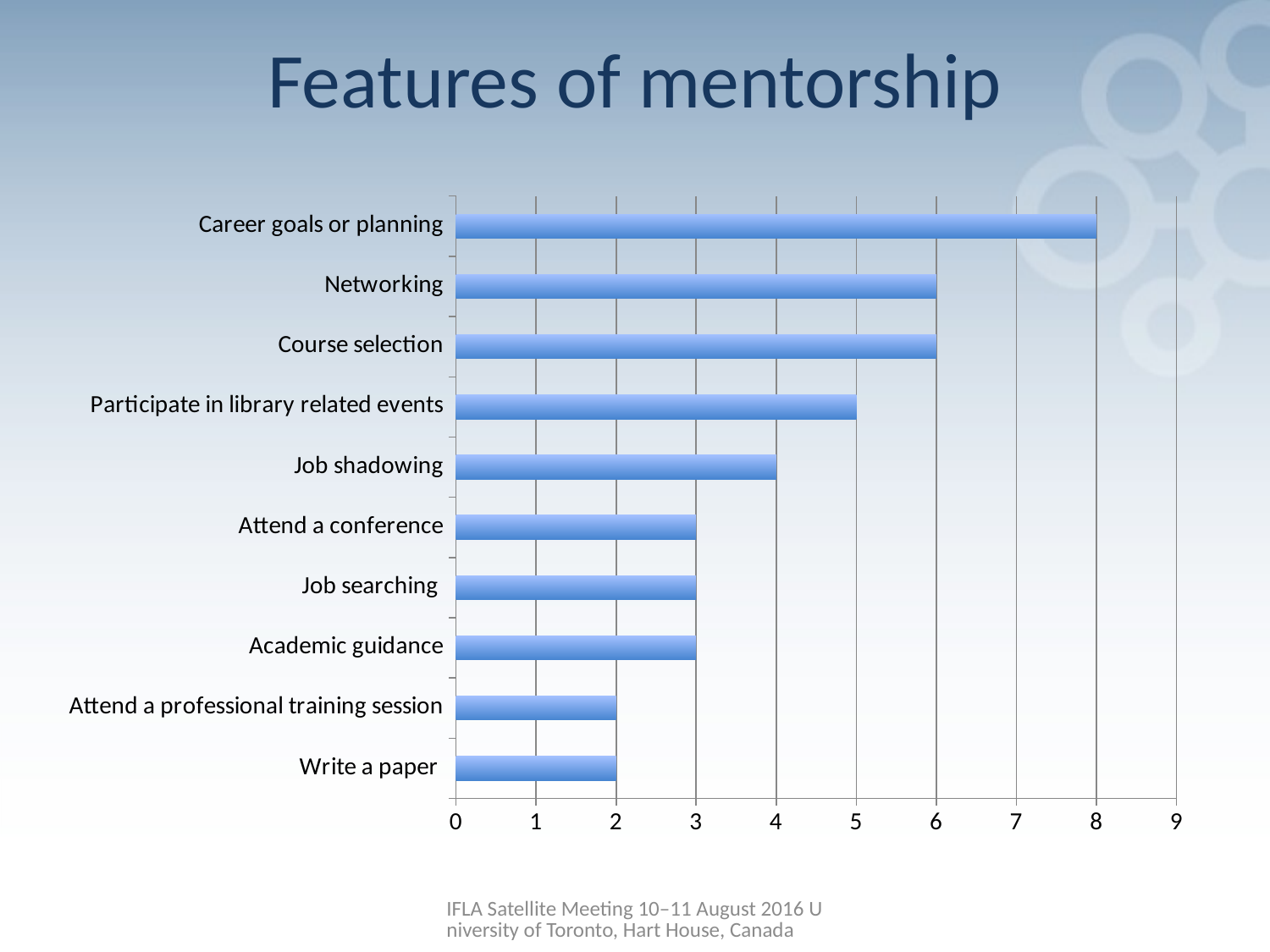
Is the value for Write a paper greater or less than 3? less What is the title of the slide containing the chart? Features of mentorship How many categories are shown in the chart? 10 What is the difference between the values for Career goals or planning and Networking? 2 What is the value for Attend a professional training session? 2 Which category has the highest value? Career goals or planning What is the value for Job shadowing? 4 What kind of chart is shown on the slide? bar chart What is the value for Participate in library related events? 5 Which is larger, the value for Job shadowing or the value for Attend a conference? Job shadowing What is the value for Career goals or planning? 8 Is the value for Networking greater or less than 5? greater